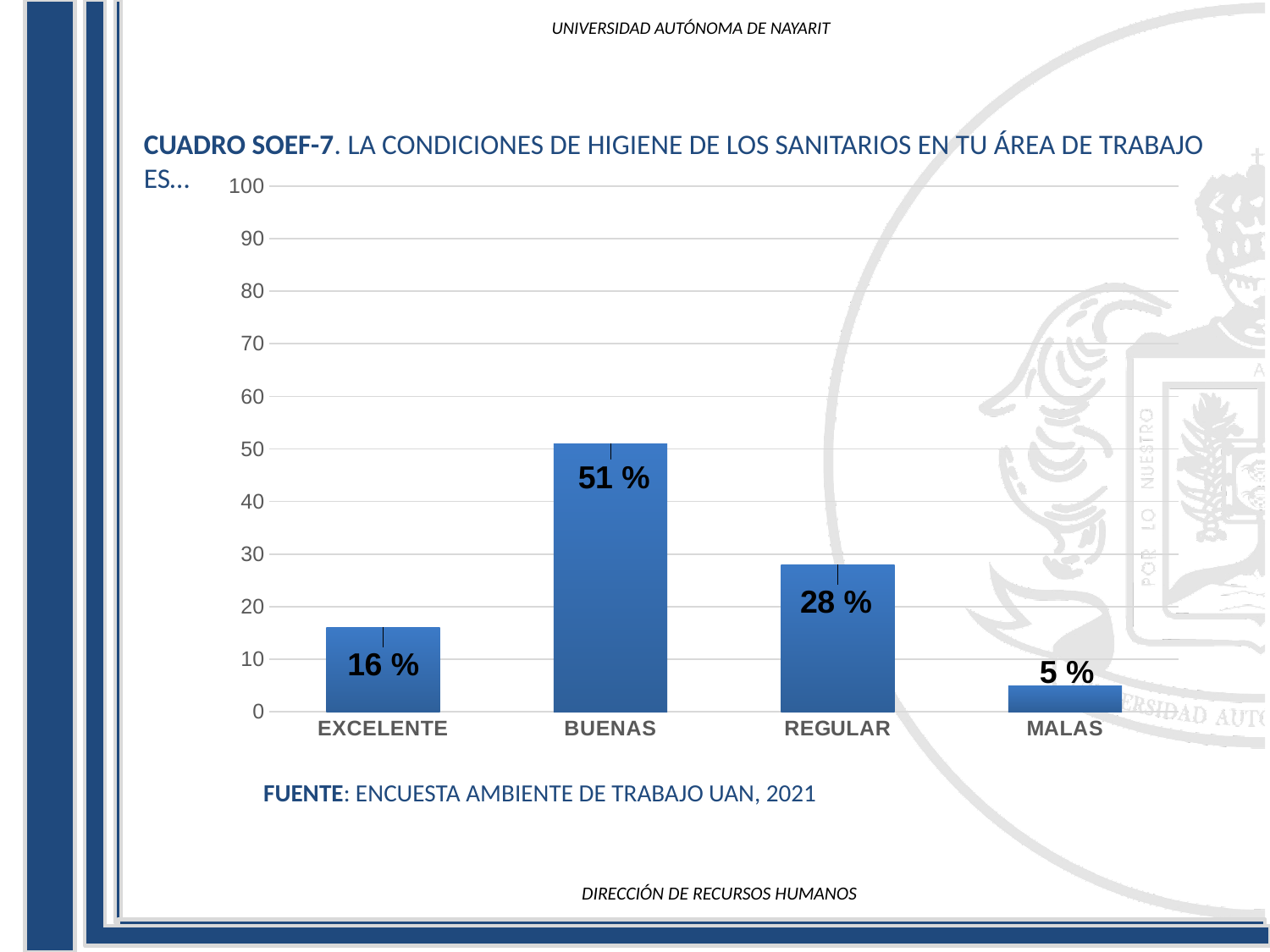
Which category has the lowest value? MALAS What is the value for MALAS? 5 % Which category has the highest value? BUENAS What is the difference between the values for BUENAS and REGULAR? 23 % What is the value for BUENAS? 51 % What is the value for EXCELENTE? 16 % Is the value for BUENAS greater or less than 50? greater What kind of chart is shown on the slide? bar chart What source is cited below the chart? ENCUESTA AMBIENTE DE TRABAJO UAN, 2021 How many categories are shown on the x axis? 4 What is the value for REGULAR? 28 % Which is larger, the value for EXCELENTE or the value for REGULAR? REGULAR